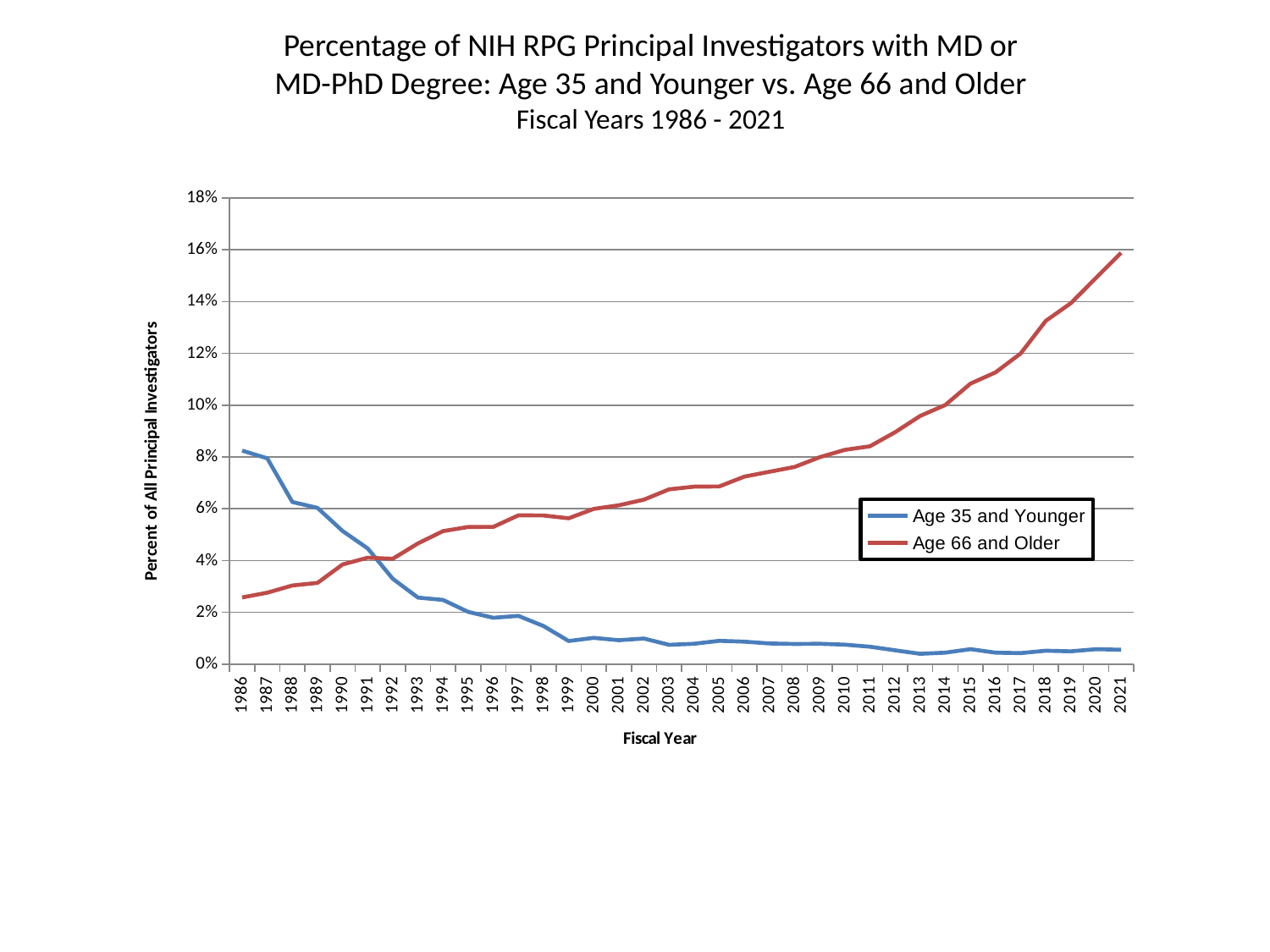
Is the Age 35 and Younger value for 2013 greater or less than 2%? less In which fiscal year is the Age 66 and Older value highest? 2021 What kind of chart is shown on the slide? Line chart Does the Age 35 and Younger line rise or fall from 1986 to 2021? Falls How many series does the legend list? 2 What is the label of the y axis? Percent of All Principal Investigators Does the Age 66 and Older line rise or fall from 1986 to 2021? Rises How many fiscal years are plotted along the x axis? 36 In which fiscal year is the Age 66 and Older value lowest? 1986 In fiscal year 2021, which series has the higher value, Age 35 and Younger or Age 66 and Older? Age 66 and Older Is the Age 66 and Older value for 2021 greater or less than 14%? greater In which fiscal year is the Age 35 and Younger value highest? 1986